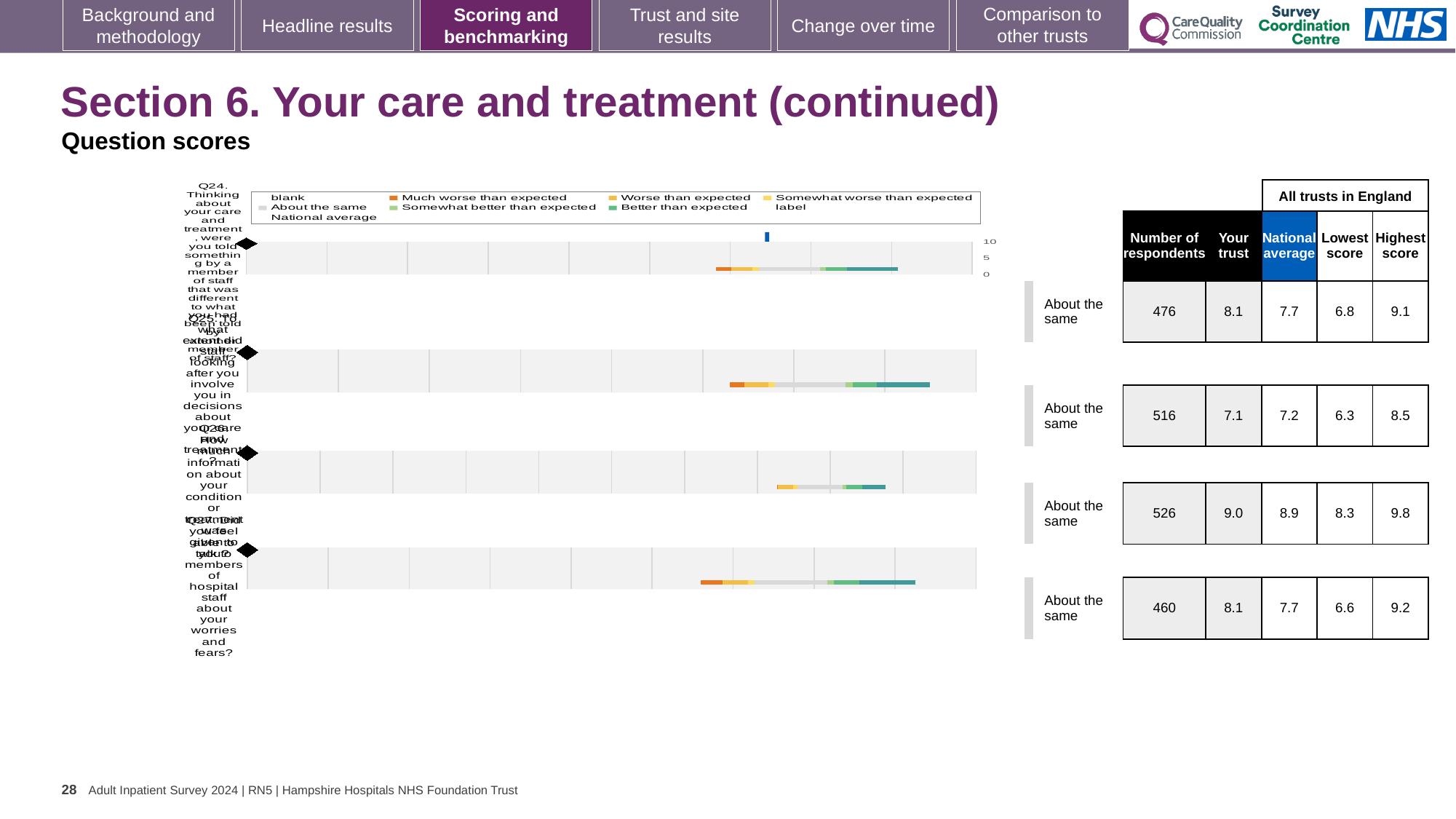
What kind of chart is used to show the question scores on this slide? Bar chart Which question has the lowest number of respondents? Q27 What is the national average score for Q27? 7.7 How many respondents are listed for Q25? 516 What benchmark category is shown for all four questions on this slide? About the same How many questions (bars) are plotted in the chart? 4 For Q26, how much higher is the 'Your trust' score than the national average? 0.1 For Q25, which is larger: the 'Your trust' score or the national average? National average What colour does the legend use for 'Much worse than expected'? Orange What is the 'Your trust' score for Q26? 9.0 Which question has the highest 'Your trust' score? Q26 For Q24, what is the difference between the highest score and the lowest score across all trusts in England? 2.3